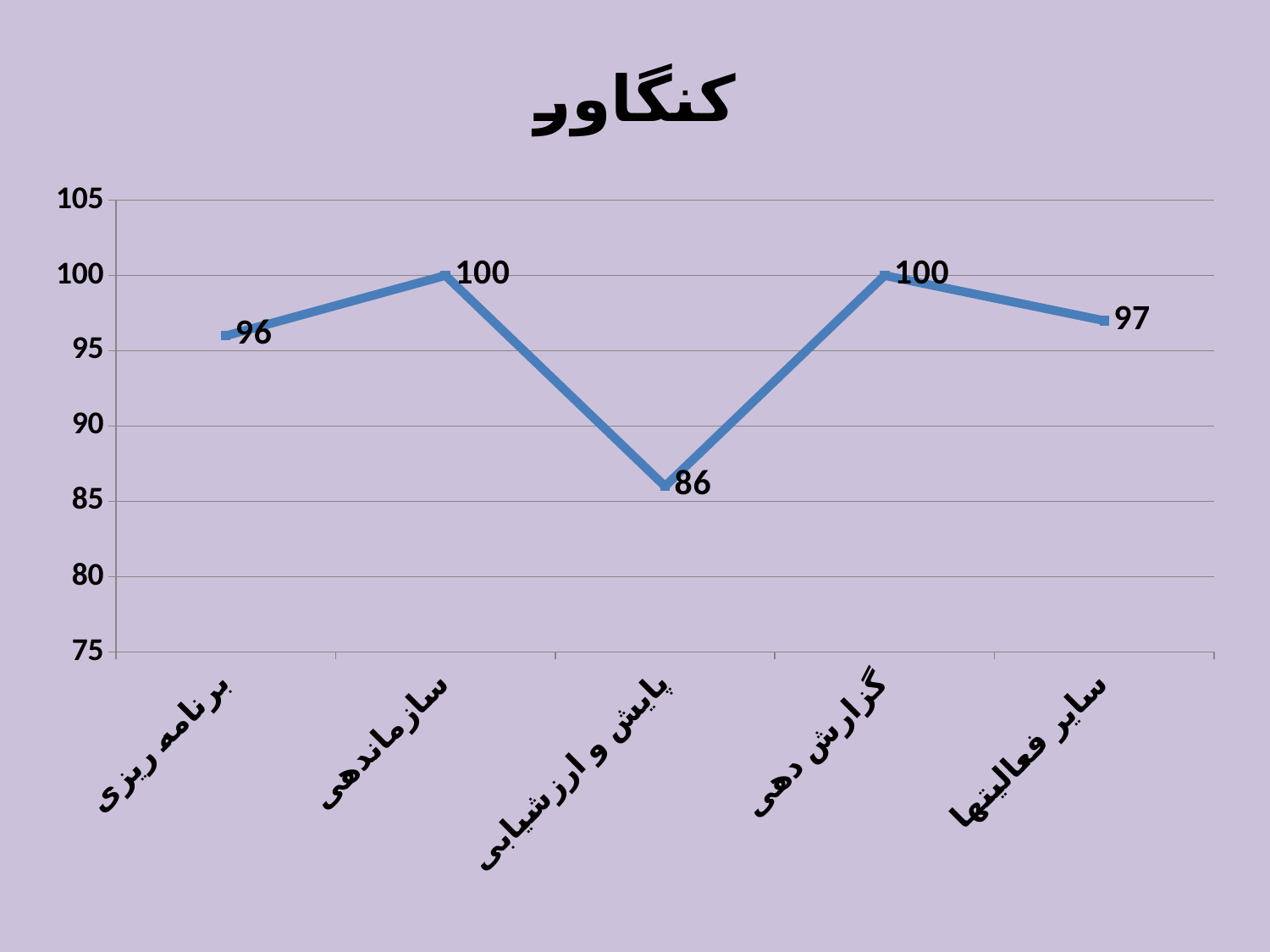
What is the value for سازماندهی? 100 What is the value for سایر فعالیتها? 97 How many categories are shown on the x axis? 5 Which category has the lowest value? پایش و ارزشیابی What is the difference between the values for سازماندهی and پایش و ارزشیابی? 14 What kind of chart is shown on the slide? line chart Which is larger, the value for برنامه ریزی or the value for پایش و ارزشیابی? برنامه ریزی What is the value for پایش و ارزشیابی? 86 What is the title of the chart? کنگاور Is the value for پایش و ارزشیابی greater or less than 90? less What is the value for برنامه ریزی? 96 What is the difference between the values for سایر فعالیتها and برنامه ریزی? 1